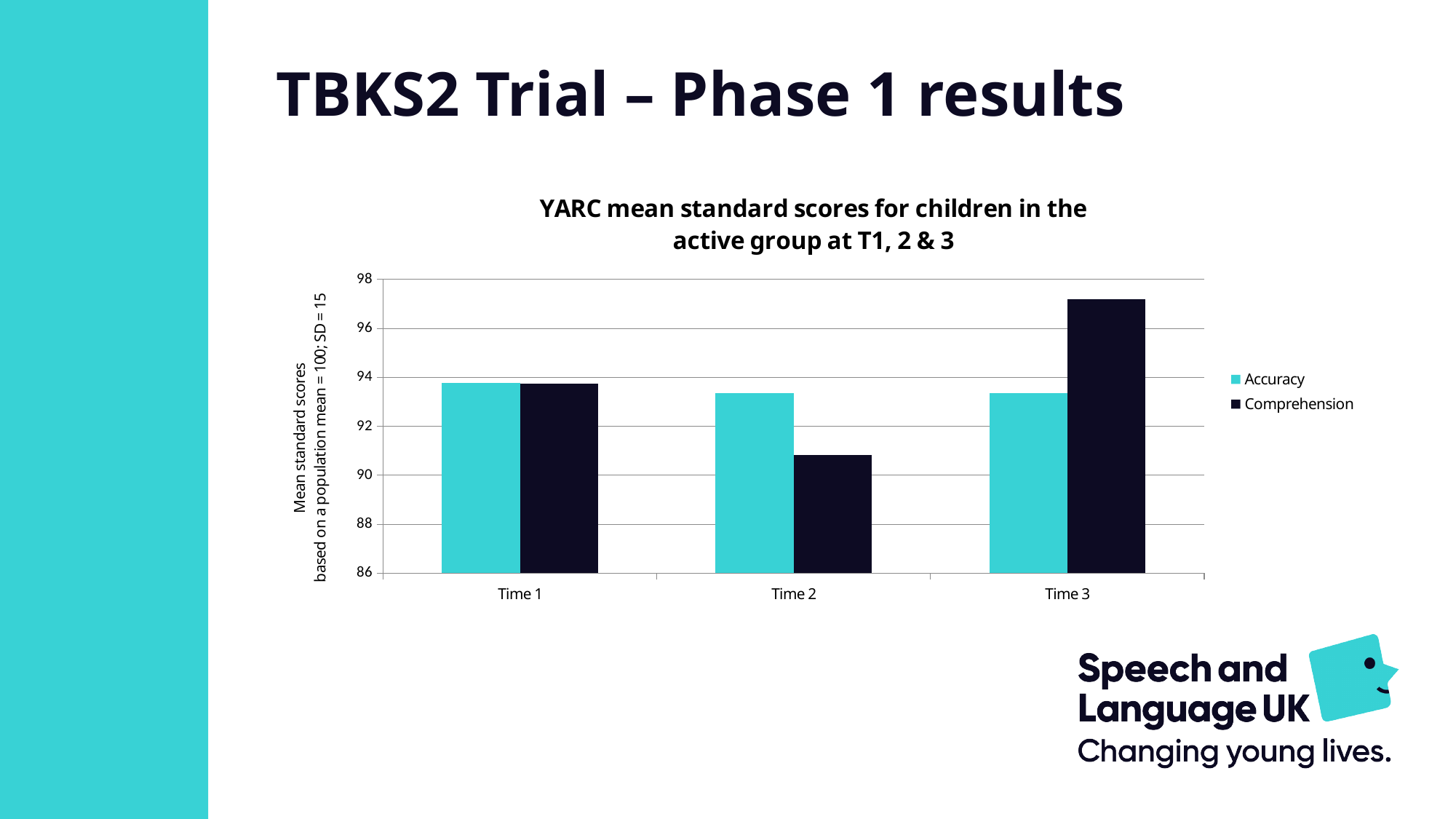
Is the Comprehension value at Time 3 greater or less than 96? greater At Time 2, which is larger: Accuracy or Comprehension? Accuracy Is the Comprehension value at Time 2 greater or less than 92? less What is the title of the chart? YARC mean standard scores for children in the active group at T1, 2 & 3 Is the Accuracy value at Time 1 greater or less than 92? greater At which time point is the Comprehension score lowest? Time 2 At which time point is the Comprehension score highest? Time 3 What kind of chart is shown on the slide? bar chart How many series does the legend list? 2 At Time 3, which is larger: Accuracy or Comprehension? Comprehension Which series is shown in dark navy bars? Comprehension How many time points are shown on the x axis? 3